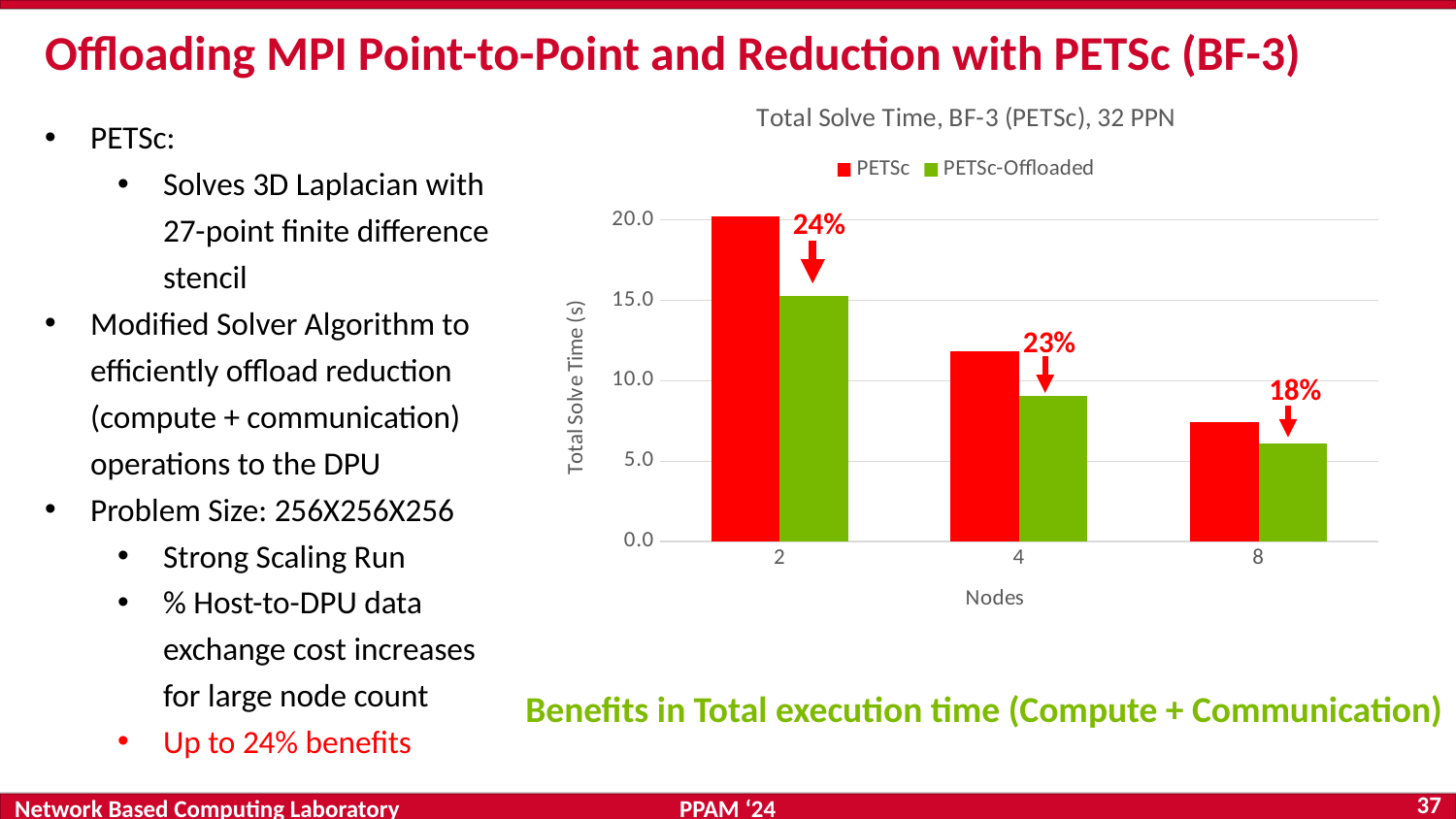
Which node count has the highest PETSc total solve time? 2 How many node counts are shown on the x axis of the chart? 3 What kind of chart is shown on the slide? bar chart Which node count has the lowest PETSc-Offloaded total solve time? 8 Is the PETSc total solve time for 8 nodes greater or less than 10.0? less Is the PETSc total solve time for 2 nodes greater or less than 15.0? greater What is the title of the chart? Total Solve Time, BF-3 (PETSc), 32 PPN Is the PETSc-Offloaded total solve time for 2 nodes greater or less than 20.0? less What percentage improvement is annotated above the bars for 4 nodes? 23% Do the PETSc total solve times rise or fall as the number of nodes increases? fall How many series does the chart legend list? 2 What percentage improvement is annotated above the bars for 8 nodes? 18%